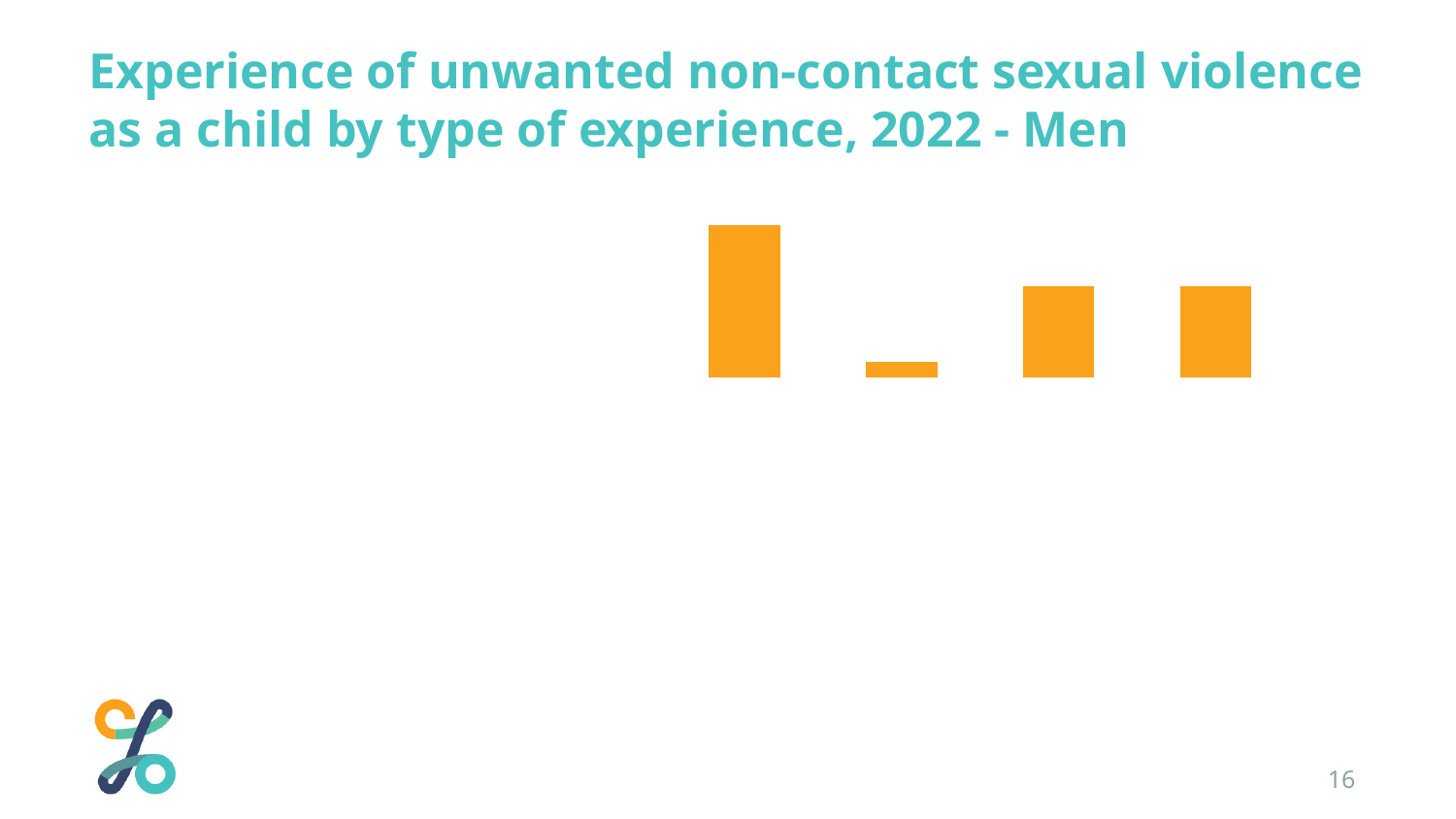
What colour are the bars in the chart? orange How many bars are plotted in the chart? 4 Which bar in the chart is the tallest, counting from the left? the first (leftmost) bar What is the title of the chart on the slide? Experience of unwanted non-contact sexual violence as a child by type of experience, 2022 - Men Which is taller: the second bar from the left or the fourth bar from the left? the fourth bar What kind of chart is shown on the slide? bar chart Which is taller: the first bar from the left or the third bar from the left? the first bar Which bar in the chart is the shortest, counting from the left? the second bar